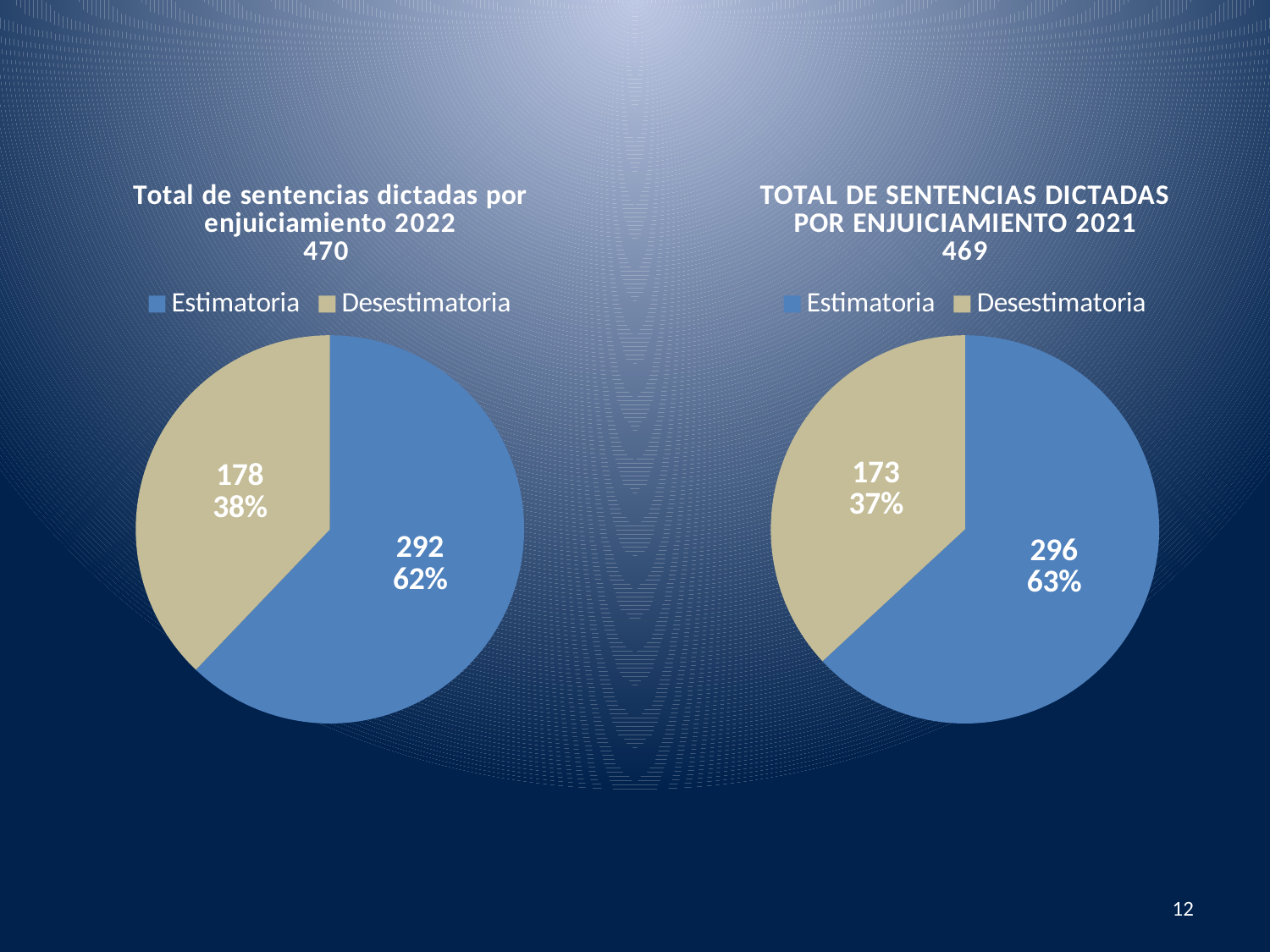
In the 2022 pie chart (left), what is the difference between Estimatoria and Desestimatoria? 114 In the 2021 pie chart (right), what is the difference between Estimatoria and Desestimatoria? 123 What type of chart is used on the left side of the slide? Pie chart In the 2022 pie chart (left), what is the value for Estimatoria? 292 In the 2021 pie chart (right), what is the value for Desestimatoria? 173 In the 2022 pie chart (left), what share of the pie does Desestimatoria represent? 38% How many categories does the legend of the 2021 pie chart (right) list? 2 In the 2022 pie chart (left), what is the value for Desestimatoria? 178 In the 2021 pie chart (right), which category is the smallest? Desestimatoria In the 2022 pie chart (left), which category is the largest? Estimatoria In the 2021 pie chart (right), what share of the pie does Estimatoria represent? 63% In the 2021 pie chart (right), what is the value for Estimatoria? 296